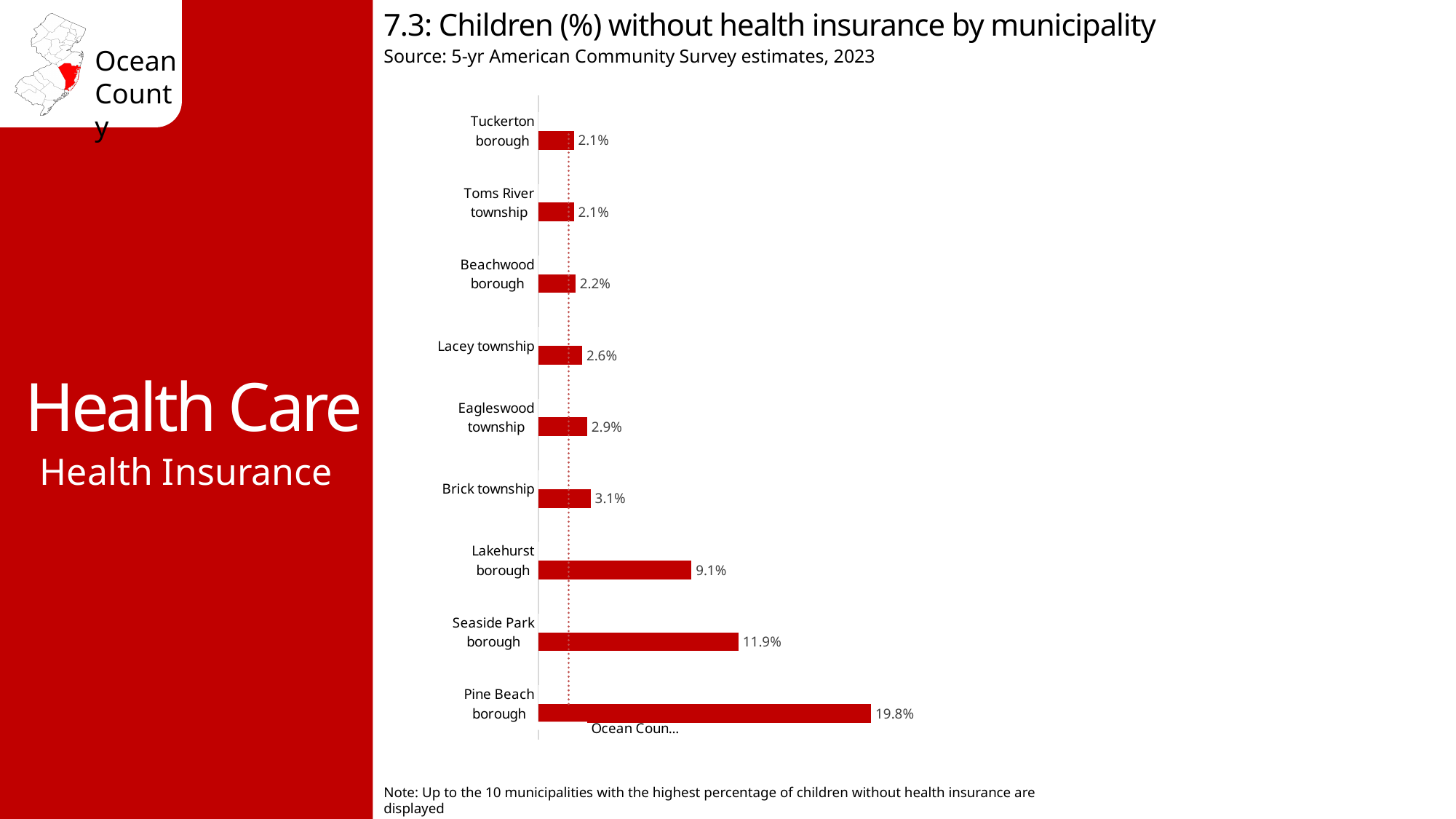
What is the difference between the values for Pine Beach borough and Seaside Park borough? 7.9% What is the value for Eagleswood township? 2.9% Which has a higher value, Lacey township or Beachwood borough? Lacey township What is the title of the chart? 7.3: Children (%) without health insurance by municipality What type of chart is used on this slide? Bar chart How many municipalities are shown in the chart? 9 What is the difference between the values for Lakehurst borough and Brick township? 6.0% What is the value shown for Lakehurst borough? 9.1% What percentage is shown for Brick township? 3.1% What percentage of children in Pine Beach borough are without health insurance? 19.8% Which has a higher value, Seaside Park borough or Lakehurst borough? Seaside Park borough Which municipality has the highest percentage of children without health insurance? Pine Beach borough